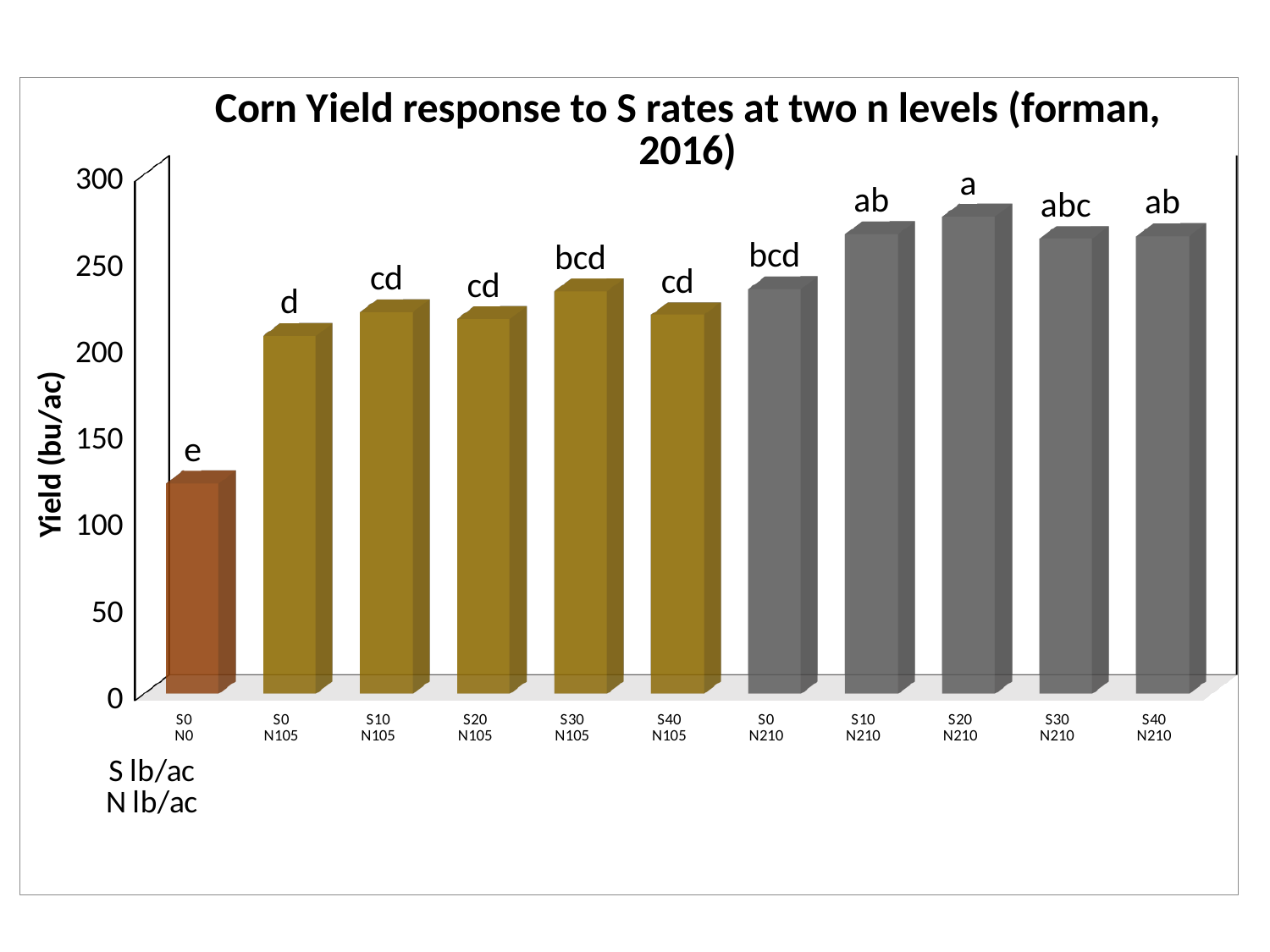
What is the label of the vertical axis? Yield (bu/ac) Is the yield for S0 N0 greater or less than 150? less Is the yield for S0 N210 greater or less than 250? less Which category has the lowest corn yield? S0 N0 Which has the higher yield, S0 N105 or S0 N210? S0 N210 How many bars are plotted in the chart? 11 Which category has the highest corn yield? S20 N210 Is the yield for S20 N210 greater or less than 250? greater What kind of chart is shown on the slide? bar chart What letter label is shown above the bar for S0 N0? e What letter label is shown above the bar for S20 N210? a